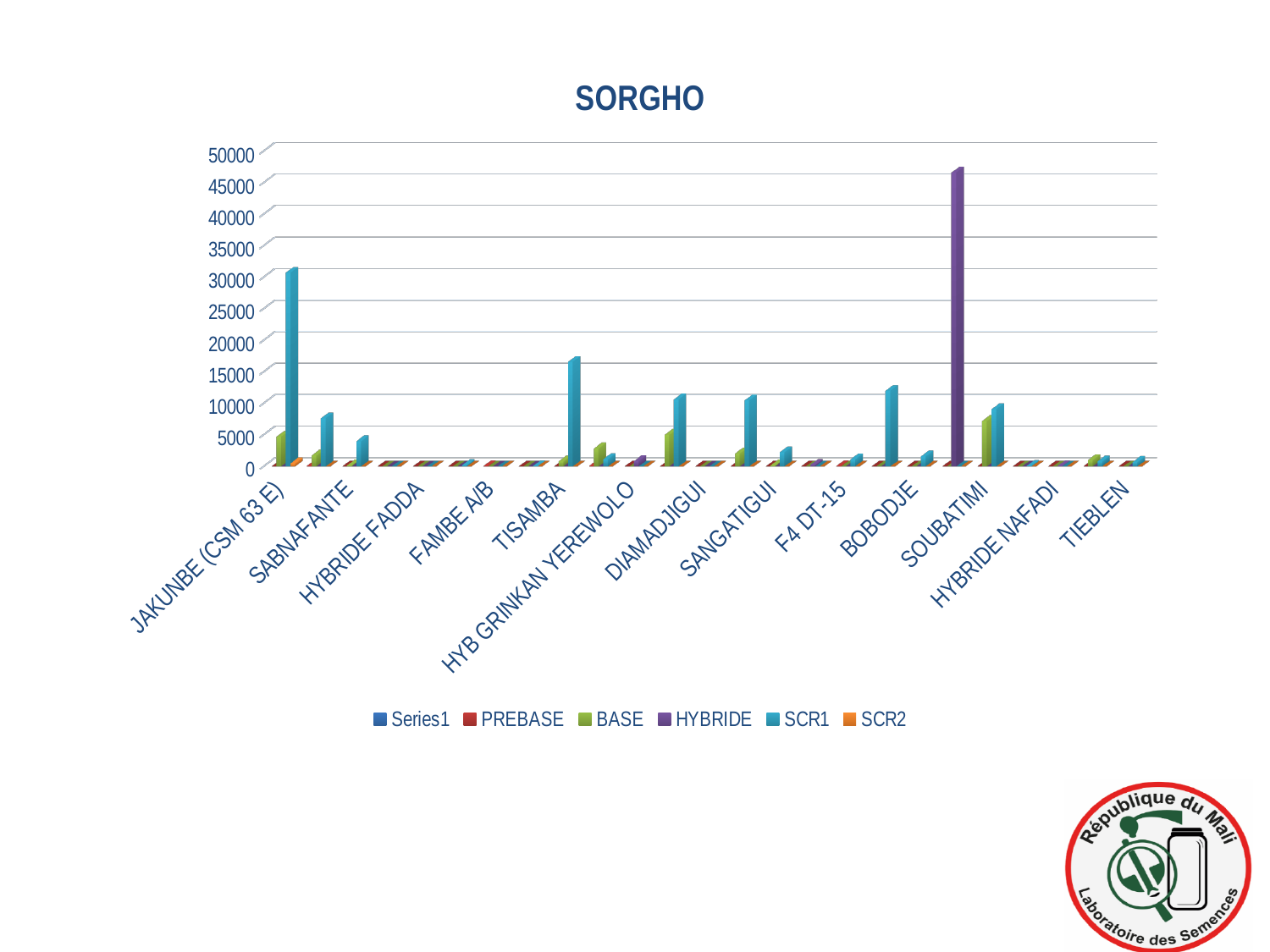
How many series does the legend list? 6 Which series has the tallest bar for SOUBATIMI? SCR1 Is the SCR1 value for JAKUNBE (CSM 63 E) greater or less than 25000? greater Which is larger, the BASE value for SOUBATIMI or the BASE value for JAKUNBE (CSM 63 E)? SOUBATIMI Which category has the highest SCR1 value? JAKUNBE (CSM 63 E) What kind of chart is shown on the slide? bar chart Is the SCR1 value for SABNAFANTE greater or less than 10000? less What is the title of the chart? SORGHO Which is larger, the SCR1 value for JAKUNBE (CSM 63 E) or the SCR1 value for TISAMBA? JAKUNBE (CSM 63 E)